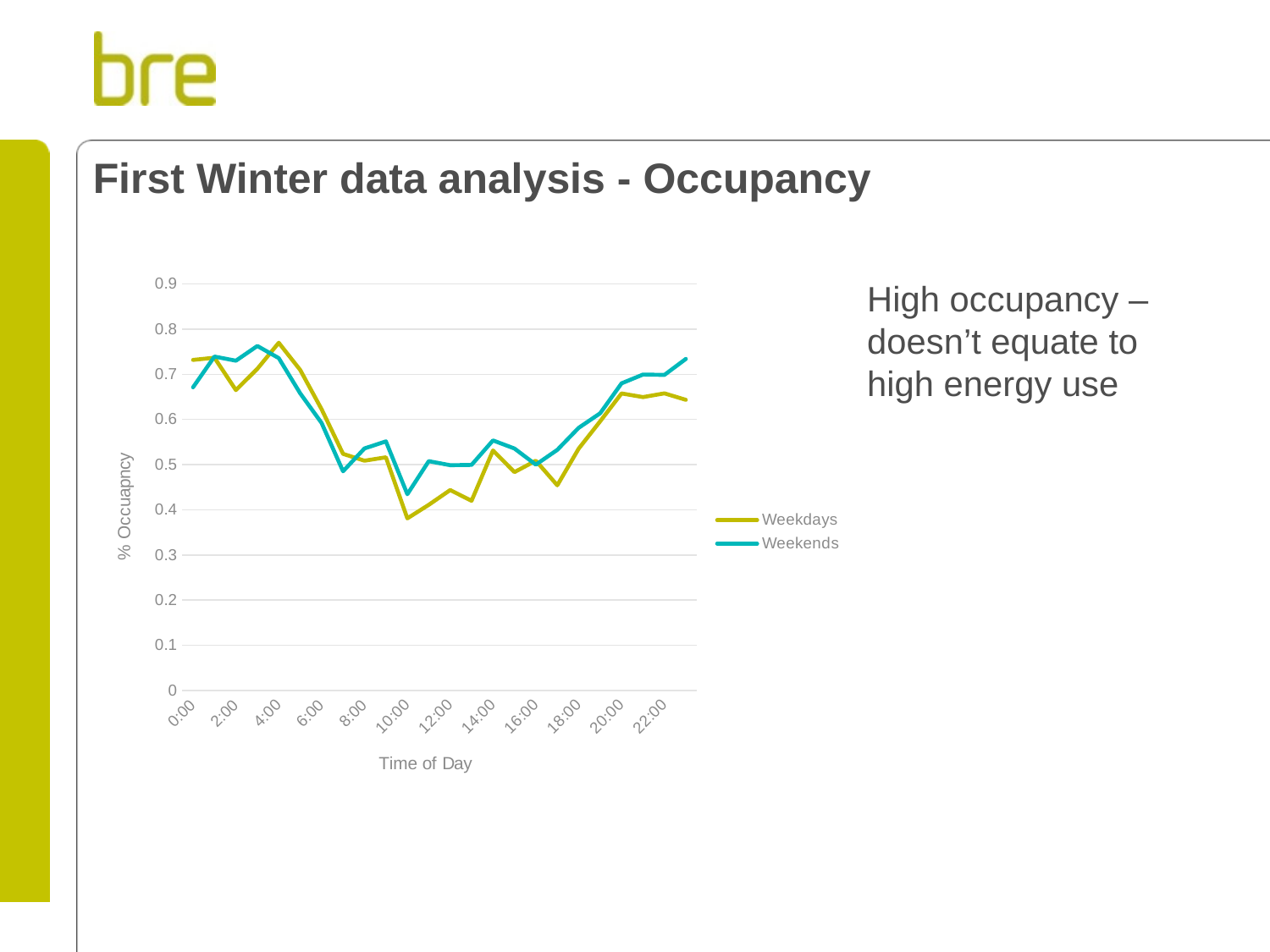
Is the Weekdays value at 10:00 greater or less than 0.5? less Between 4:00 and 10:00, does the Weekdays series rise or fall? Fall How many series does the chart legend list? 2 What is the title of the x axis of the chart? Time of Day At 12:00, which series has the higher occupancy, Weekdays or Weekends? Weekends At 10:00, which series has the higher occupancy, Weekdays or Weekends? Weekends What kind of chart is shown on the slide? Line chart At what time of day does the Weekdays series reach its lowest value? 10:00 Is the Weekdays value at 12:00 greater or less than 0.5? less What are the two series named in the chart legend? Weekdays and Weekends Is the Weekends value at 22:00 greater or less than 0.6? greater